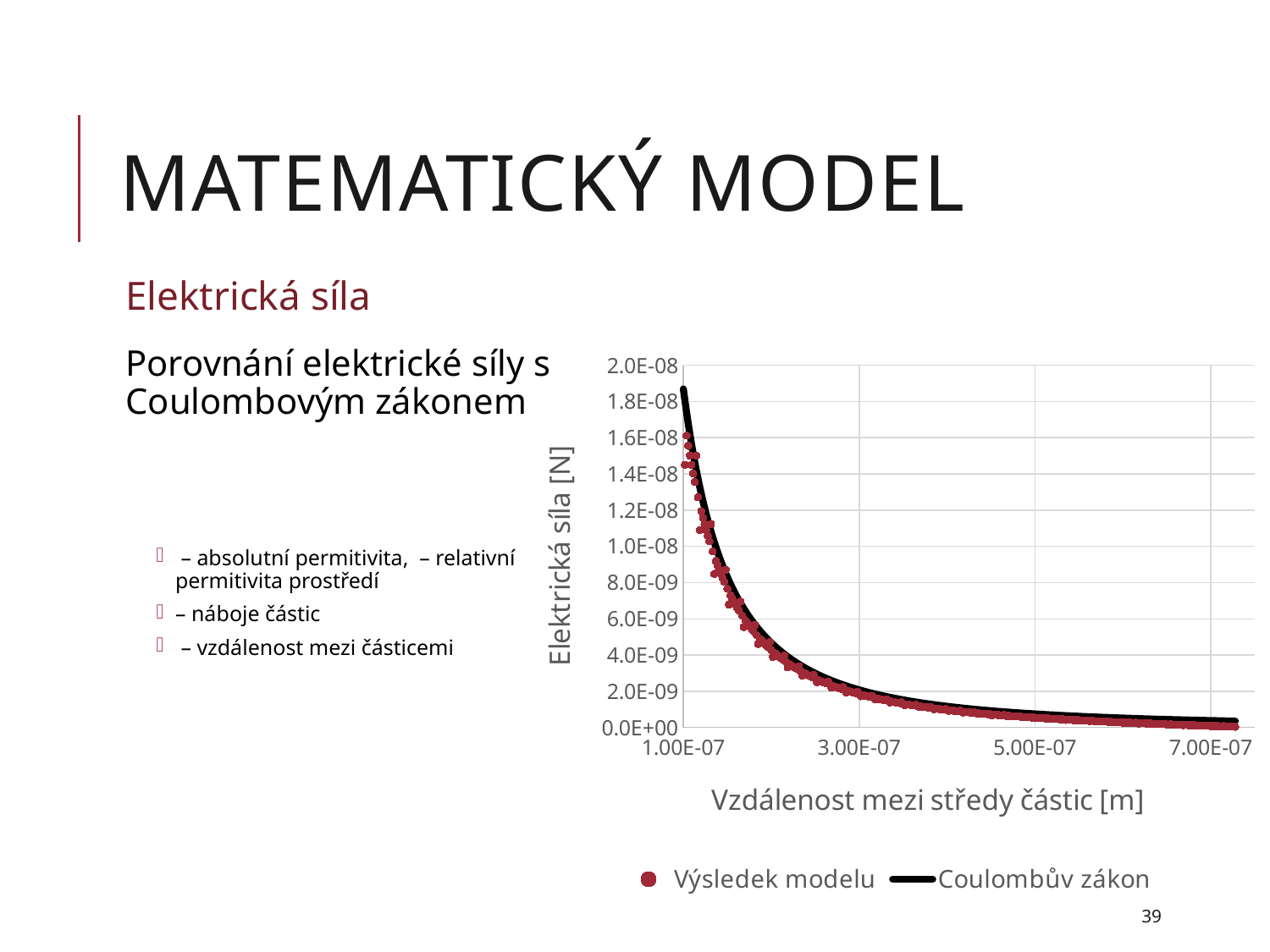
How many series does the chart legend list? 2 What are the two series named in the chart legend? Výsledek modelu, Coulombův zákon What is the highest tick value shown on the chart's y axis? 2.0E-08 Is the Coulombův zákon value at 1.00E-07 m greater or less than 1.4E-08 N? greater What is the label of the chart's x axis? Vzdálenost mezi středy částic [m] Is the Výsledek modelu value at 5.00E-07 m greater or less than 4.0E-09 N? less Do the values of the Coulombův zákon series rise or fall as the distance on the x axis increases? fall Is the Výsledek modelu value at 7.00E-07 m greater or less than 2.0E-09 N? less Do the Výsledek modelu values rise or fall along the x axis? fall What kind of chart is shown on the slide? scatter chart